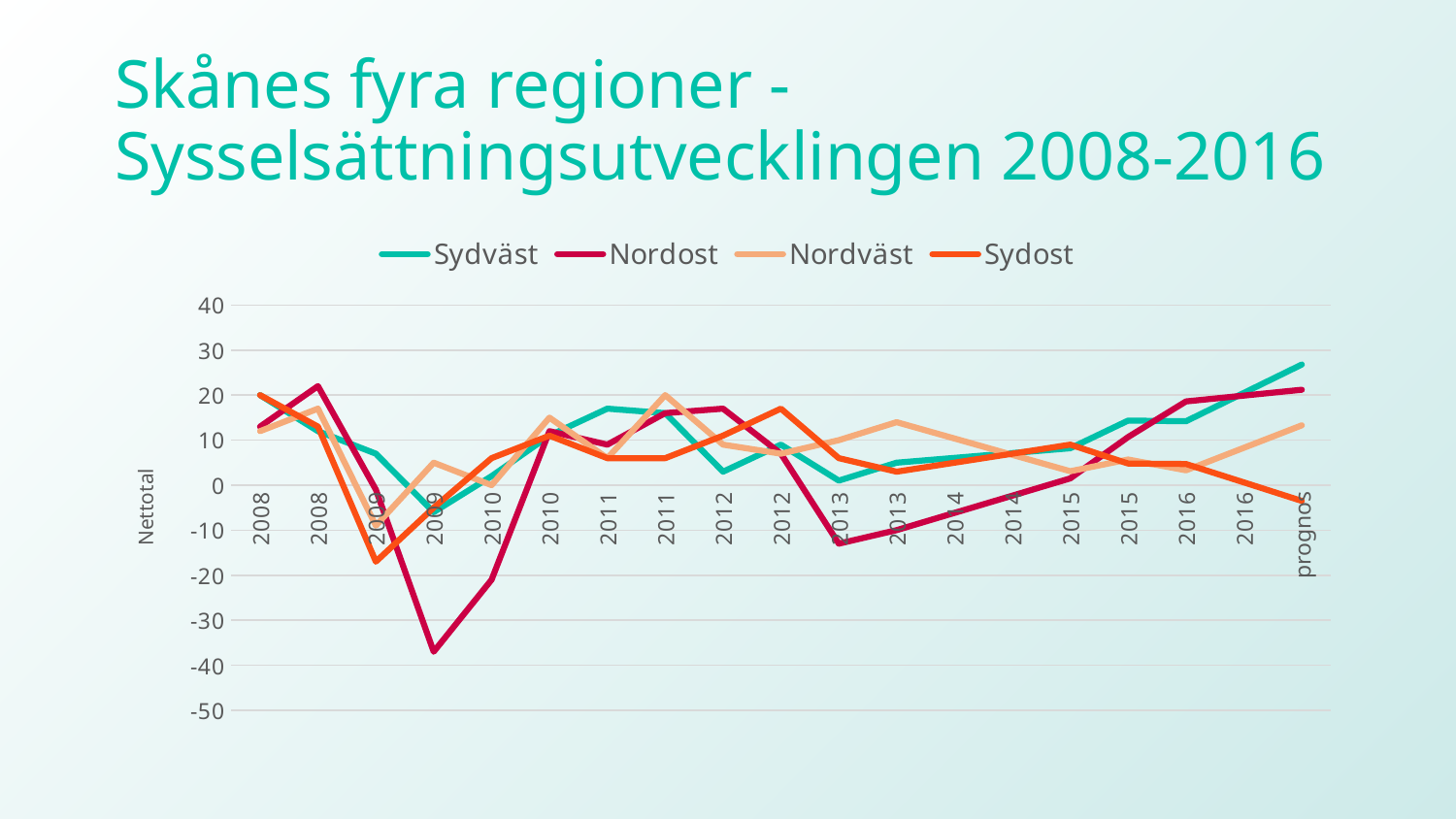
Which series has the highest value at 'prognos'? Sydväst Which series are listed in the legend? Sydväst, Nordost, Nordväst, Sydost How many series does the legend list? 4 Is the value for Sydväst at 'prognos' greater or less than 20? greater What is the label on the vertical axis? Nettotal Does the Sydväst line rise or fall from the second 2015 point to 'prognos'? rise Is the lowest value for Nordost in 2009 greater or less than -30? less How many points are there along the x axis, including 'prognos'? 19 Which series has the lowest value at 'prognos'? Sydost At 'prognos', which is larger: the value for Nordost or the value for Nordväst? Nordost What kind of chart is shown on the slide? line chart Which series reaches the lowest value anywhere on the chart? Nordost